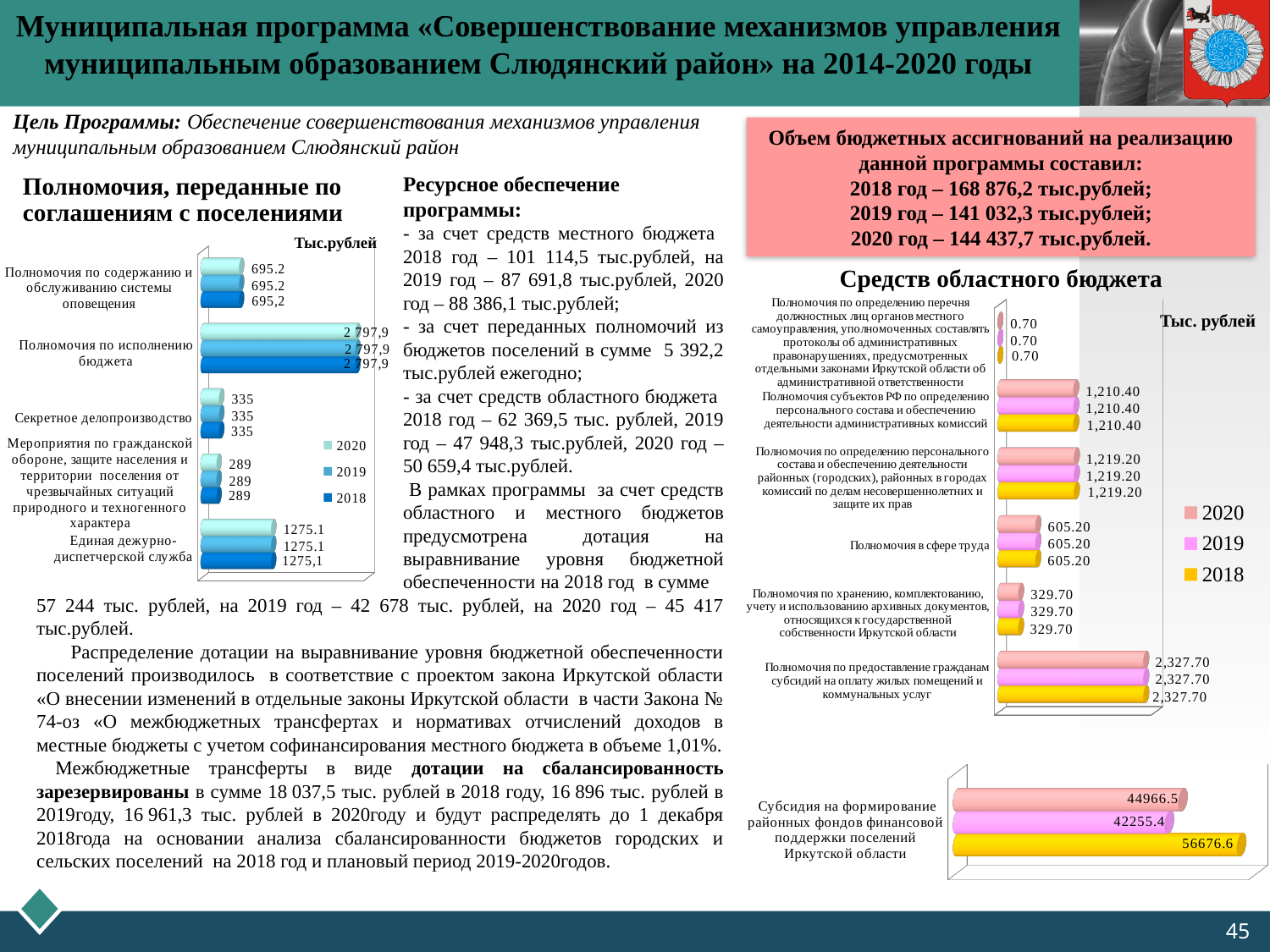
In the chart 'Полномочия, переданные по соглашениям с поселениями', what is the difference between the 2020 values for 'Единая дежурно-диспетчерская служба' and 'Секретное делопроизводство'? 940.1 In the chart 'Средств областного бюджета', what is the 2019 value for 'Полномочия в сфере труда'? 605.20 In the chart 'Средств областного бюджета', how many categories are shown? 6 In the bottom-right chart 'Субсидия на формирование районных фондов финансовой поддержки поселений Иркутской области', what is the largest value shown? 56676.6 In the chart 'Полномочия, переданные по соглашениям с поселениями', what is the value for 'Секретное делопроизводство' in 2020? 335 In the chart 'Средств областного бюджета', which category has the highest values? Полномочия по предоставлению гражданам субсидий на оплату жилых помещений и коммунальных услуг In the chart 'Полномочия, переданные по соглашениям с поселениями', what is the value for 'Полномочия по исполнению бюджета' in 2018? 2 797,9 In the chart 'Средств областного бюджета', which is larger: the 2018 value for 'Полномочия по хранению, комплектованию, учету и использованию архивных документов' or the 2018 value for 'Полномочия в сфере труда'? Полномочия в сфере труда In the chart 'Полномочия, переданные по соглашениям с поселениями', which category has the lowest values? Мероприятия по гражданской обороне, защите населения и территории поселения от чрезвычайных ситуаций природного и техногенного характера What kind of chart is 'Средств областного бюджета'? Bar chart In the chart 'Полномочия, переданные по соглашениям с поселениями', how many series does the legend list? 3 In the chart 'Полномочия, переданные по соглашениям с поселениями', which category has the highest values? Полномочия по исполнению бюджета